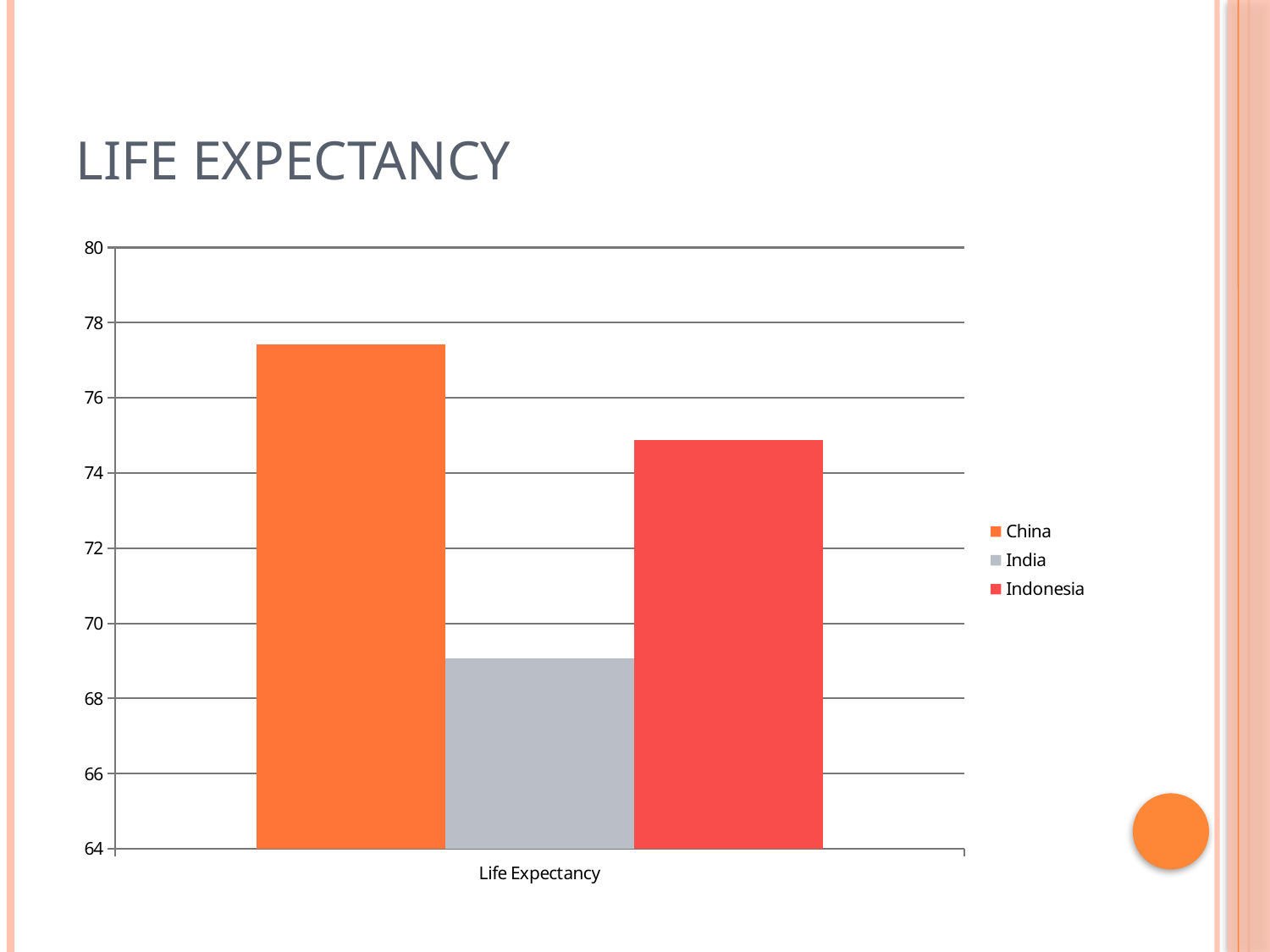
How many categories are shown on the x axis? 1 What kind of chart is shown on the slide? bar chart Is the value for India greater or less than 70? less What is the title of the slide? LIFE EXPECTANCY How many series does the legend list? 3 Is the value for Indonesia greater or less than 74? greater Which is larger, the value for China or the value for Indonesia? China What is the label shown on the x axis of the chart? Life Expectancy Which series has the lowest life expectancy? India Is the value for China greater or less than 76? greater Which is larger, the value for India or the value for Indonesia? Indonesia Which series has the highest life expectancy? China